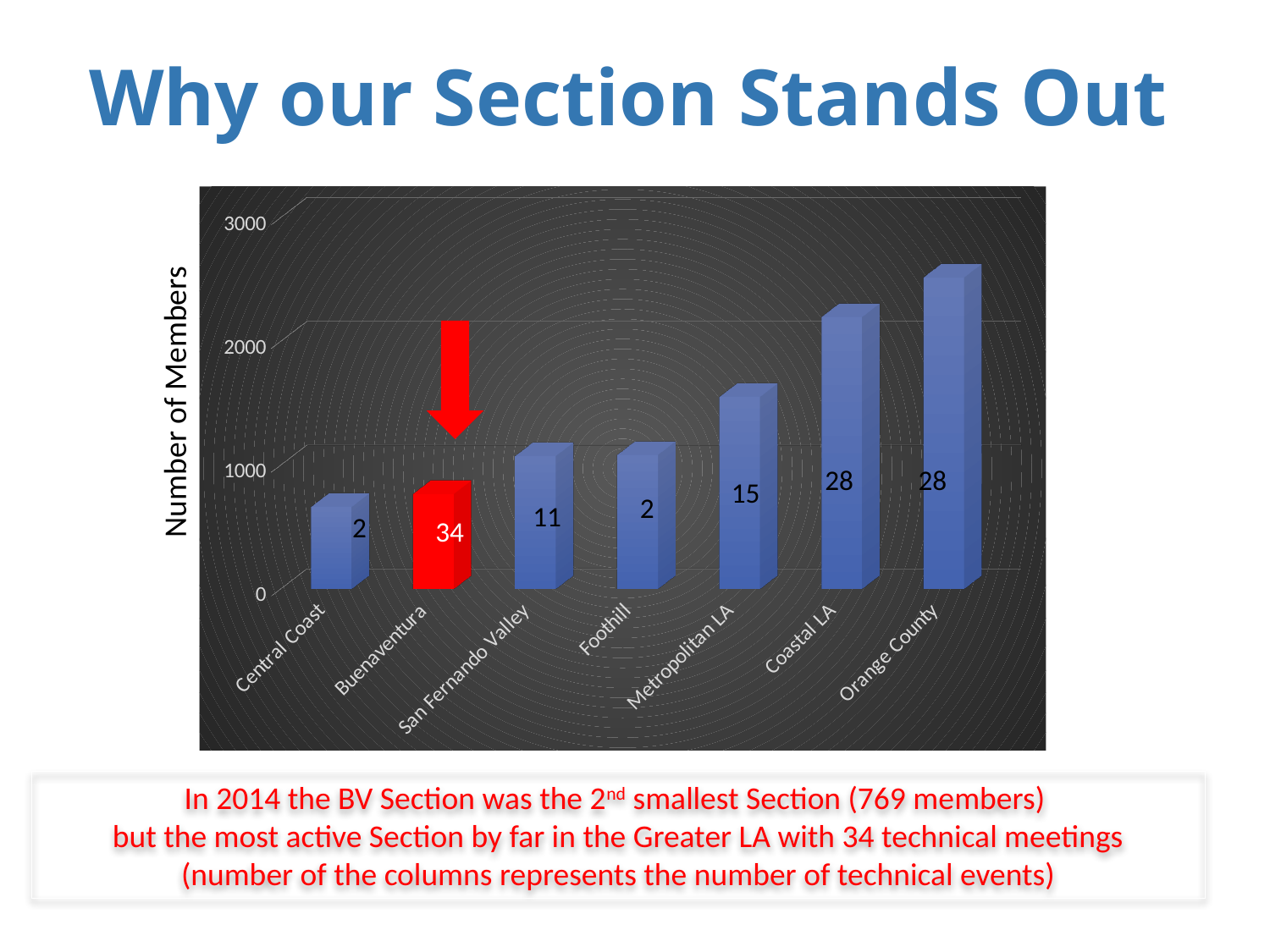
What number is printed on the Buenaventura bar? 34 Which bar is taller, Metropolitan LA or Coastal LA? Coastal LA Is the bar for Orange County greater or less than 2000 members? greater Is the bar for Metropolitan LA greater or less than 2000 members? less Is the bar for Central Coast greater or less than 1000 members? less What number is printed on the San Fernando Valley bar? 11 Which category has the tallest bar? Orange County What kind of chart is shown on the slide? bar chart What number is printed on the Metropolitan LA bar? 15 What is the difference between the numbers printed on the Buenaventura and San Fernando Valley bars? 23 How many categories are shown on the x axis? 7 Which category's bar is coloured red? Buenaventura